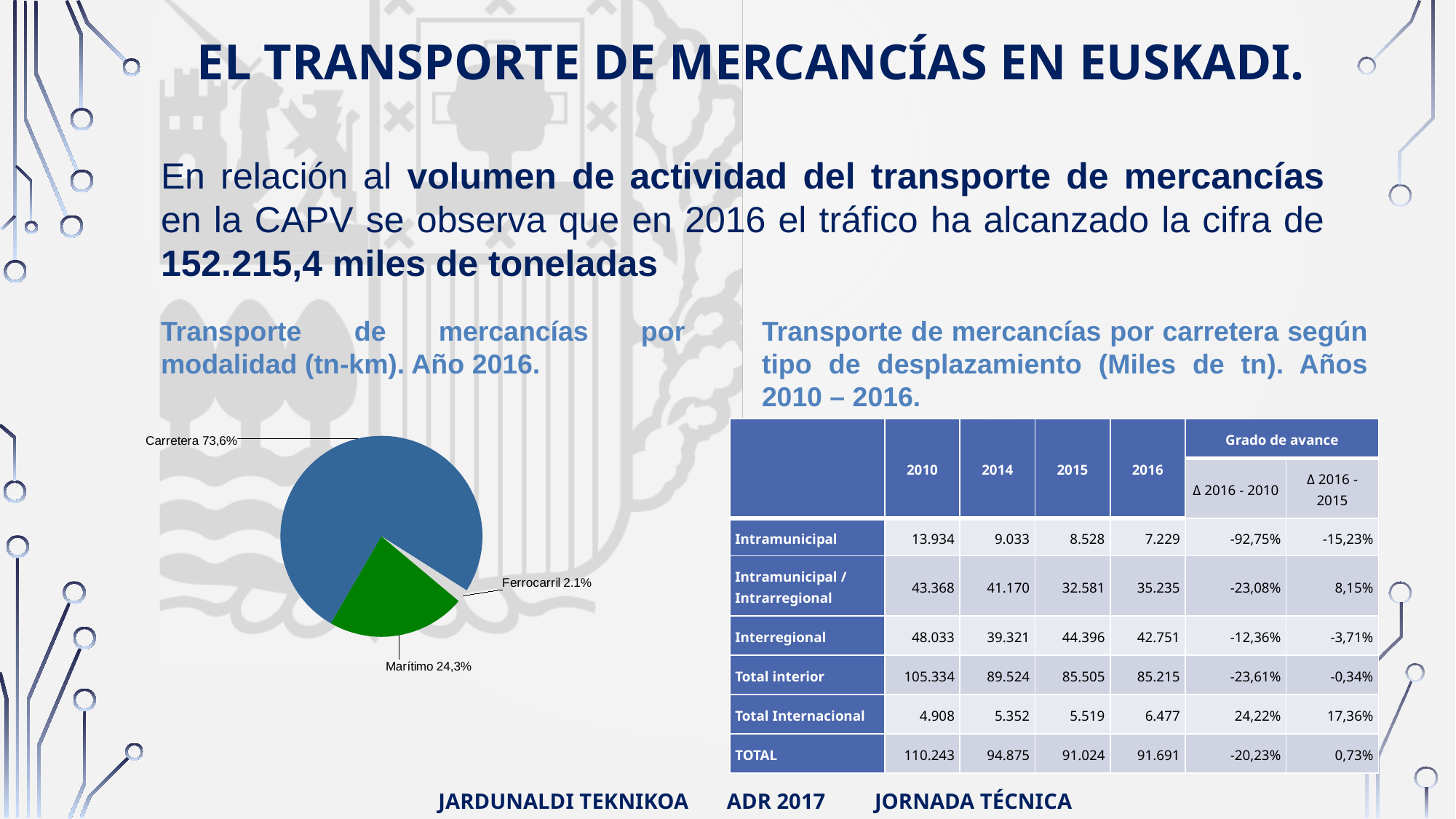
Which slice of the pie chart is the largest? Carretera What share of the pie chart does Marítimo represent? 24,3% Which slice of the pie chart is the smallest? Ferrocarril What kind of chart is shown on the slide? pie chart What share of the pie chart does Ferrocarril represent? 2.1% What share of the pie chart does Carretera represent? 73,6% How many slices does the pie chart have? 3 What is the title of the pie chart? Transporte de mercancías por modalidad (tn-km). Año 2016. What colour is the Marítimo slice in the pie chart? green What is the difference in percentage points between the Carretera and Marítimo shares in the pie chart? 49,3 Which has a larger share in the pie chart, Marítimo or Ferrocarril? Marítimo